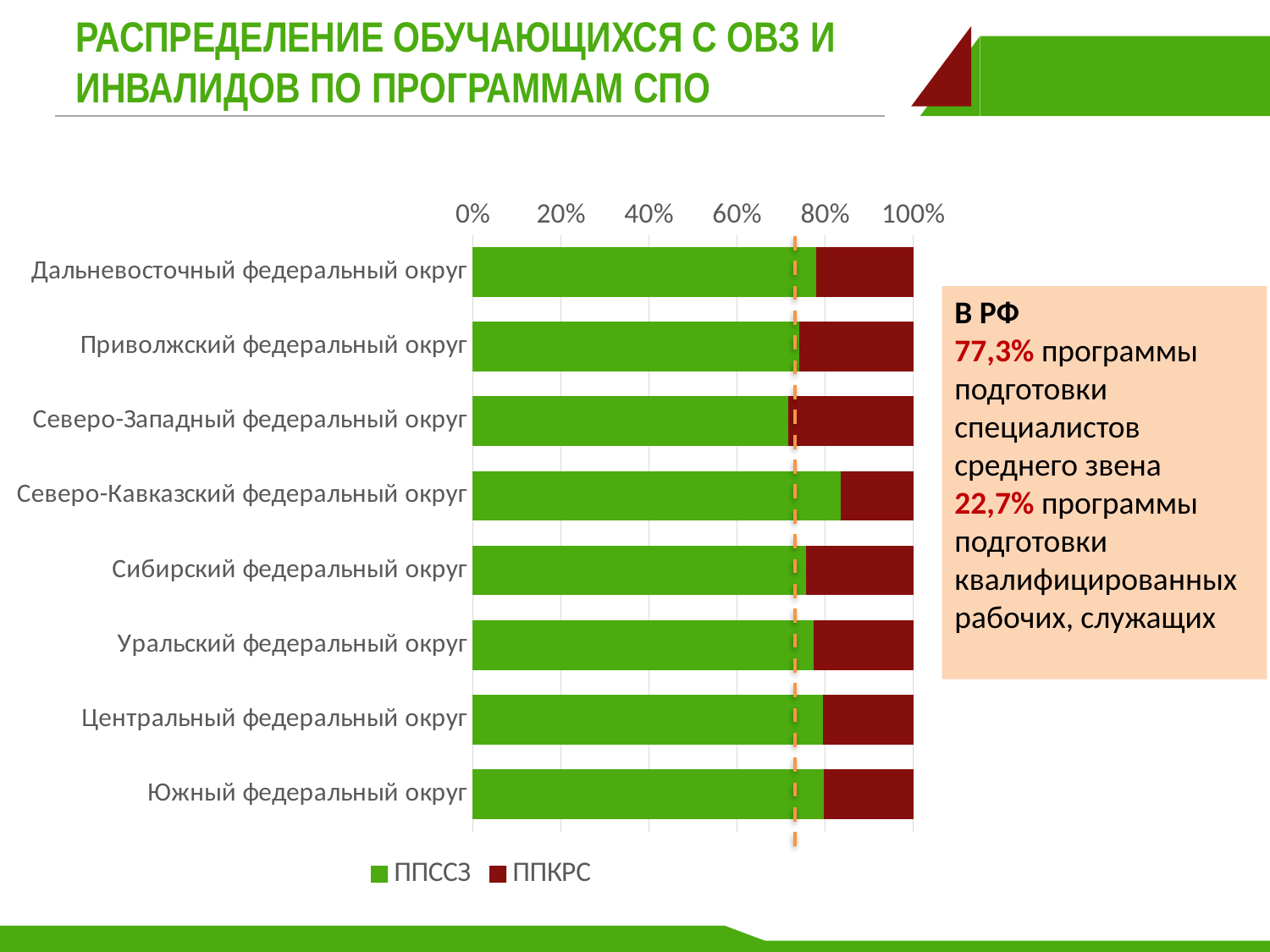
What kind of chart is shown on the slide? Stacked bar chart How many series does the chart legend list? 2 Which federal district has the lowest share of ППССЗ? Северо-Западный федеральный округ How many federal districts (categories) are shown in the chart? 8 What are the two series named in the chart legend? ППССЗ and ППКРС Is the ППКРС share for Северо-Кавказский федеральный округ greater or less than 20%? less According to the text box next to the chart, what is the share of ППССЗ programmes in the Russian Federation overall? 77,3% Which has a larger ППССЗ share: Северо-Кавказский федеральный округ or Сибирский федеральный округ? Северо-Кавказский федеральный округ Which federal district has the highest share of ППССЗ? Северо-Кавказский федеральный округ Is the ППССЗ share for Северо-Кавказский федеральный округ greater or less than 80%? greater Which federal district has the largest share of ППКРС? Северо-Западный федеральный округ Is the ППССЗ share for Северо-Западный федеральный округ greater or less than 80%? less